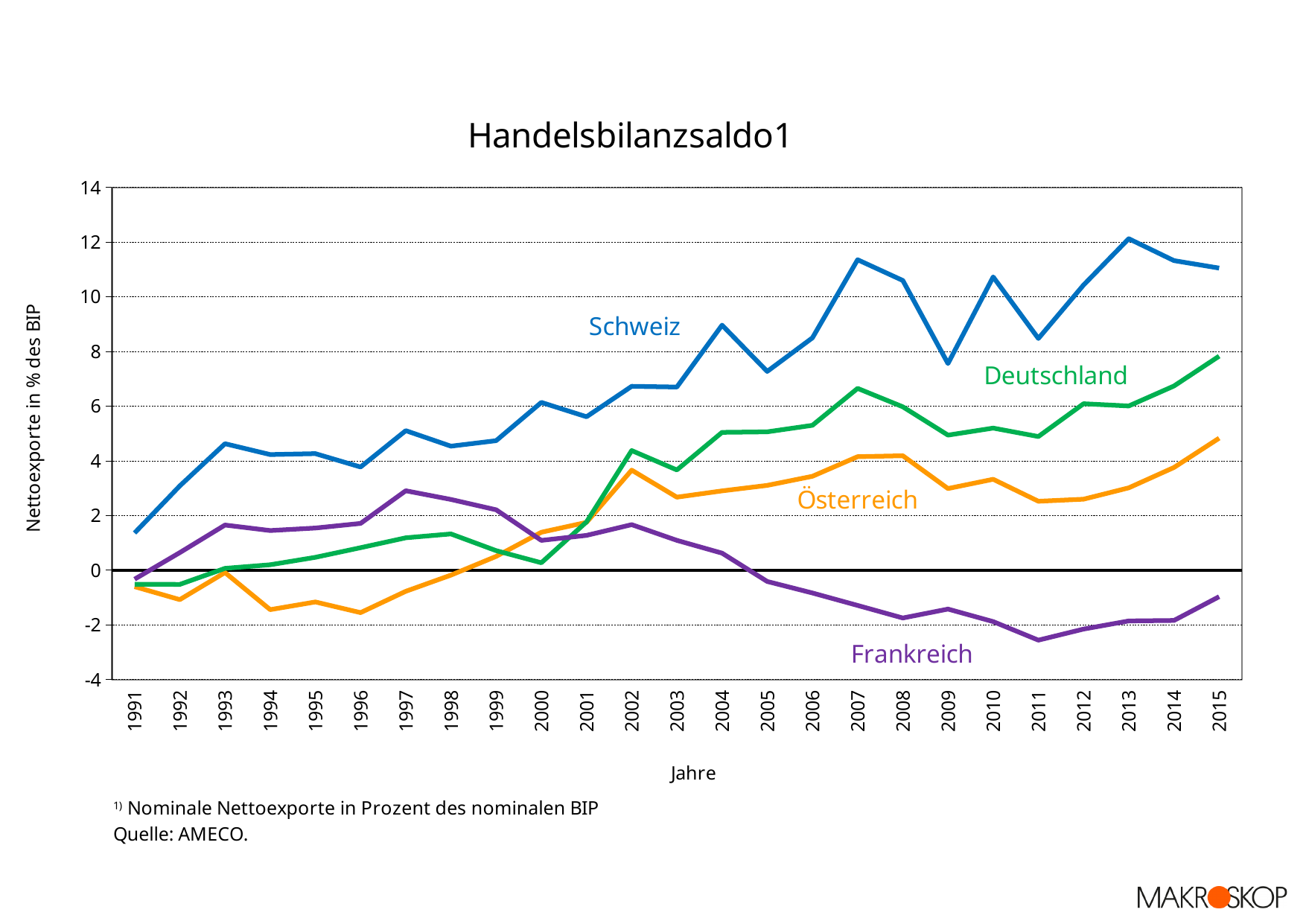
How many years are shown on the x axis of the chart? 25 Which country has the highest value in 2015? Schweiz Does the Frankreich line rise or fall between 2002 and 2011? Fall Which is larger in 1997, the value for Frankreich or the value for Deutschland? Frankreich What is the label of the y axis of the chart? Nettoexporte in % des BIP Is the value for Schweiz in 2007 greater or less than 10? greater What kind of chart is shown on the slide? Line chart How many countries (series) are plotted in the chart? 4 Is the value for Frankreich in 2011 greater or less than -2? less In which year does the Schweiz line reach its highest value? 2013 Is the value for Deutschland in 2015 greater or less than 6? greater Which country has the lowest value in 2015? Frankreich